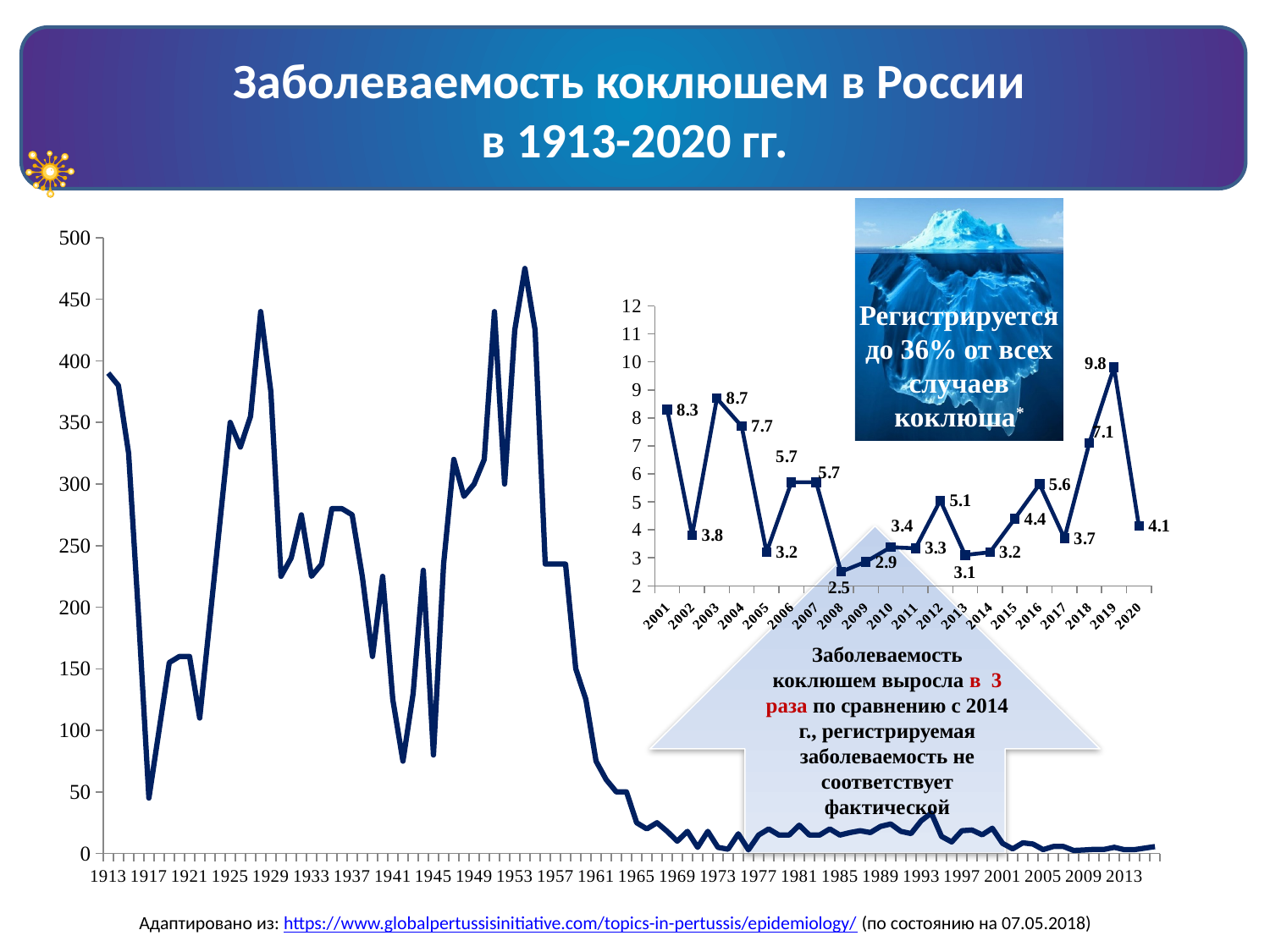
In the inset chart (2001-2020), what is the difference between the values for 2003 and 2002? 4.9 In the inset chart (2001-2020), what is the value for 2014? 3.2 In the inset chart (2001-2020), what is the value for 2019? 9.8 In the inset chart (2001-2020), which year has the larger value, 2018 or 2016? 2018 In the inset chart (2001-2020), how many years are plotted? 20 In the inset chart (2001-2020), which year has the highest value? 2019 In the inset chart (2001-2020), what is the difference between the values for 2019 and 2020? 5.7 In the large chart starting in 1913, is the value for 1917 greater or less than 100? less In the inset chart (2001-2020), which year has the lowest value? 2008 In the inset chart (2001-2020), what is the value for 2008? 2.5 What type of chart is the large chart starting in 1913? line chart